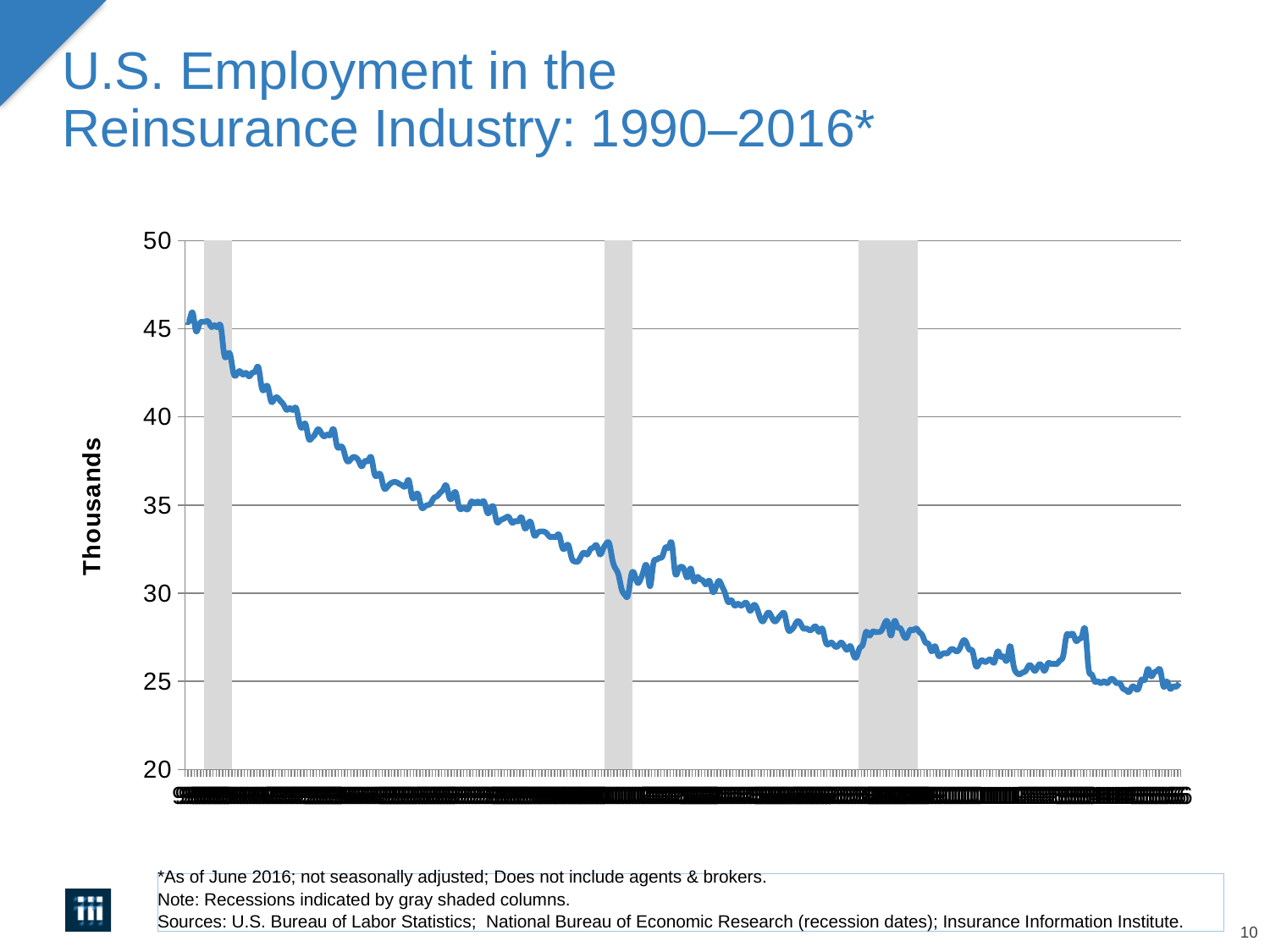
How many gray shaded recession columns are shown on the chart? 3 Is the highest value on the line greater or less than 50? less Is the value of the line during the third gray shaded recession column greater or less than 35? less What is the label on the y axis? Thousands Is the value at the end of the series (2016) greater or less than 30? less Overall, do the values rise or fall from 1990 to 2016 along the x axis? fall What kind of chart is shown on the slide? line chart